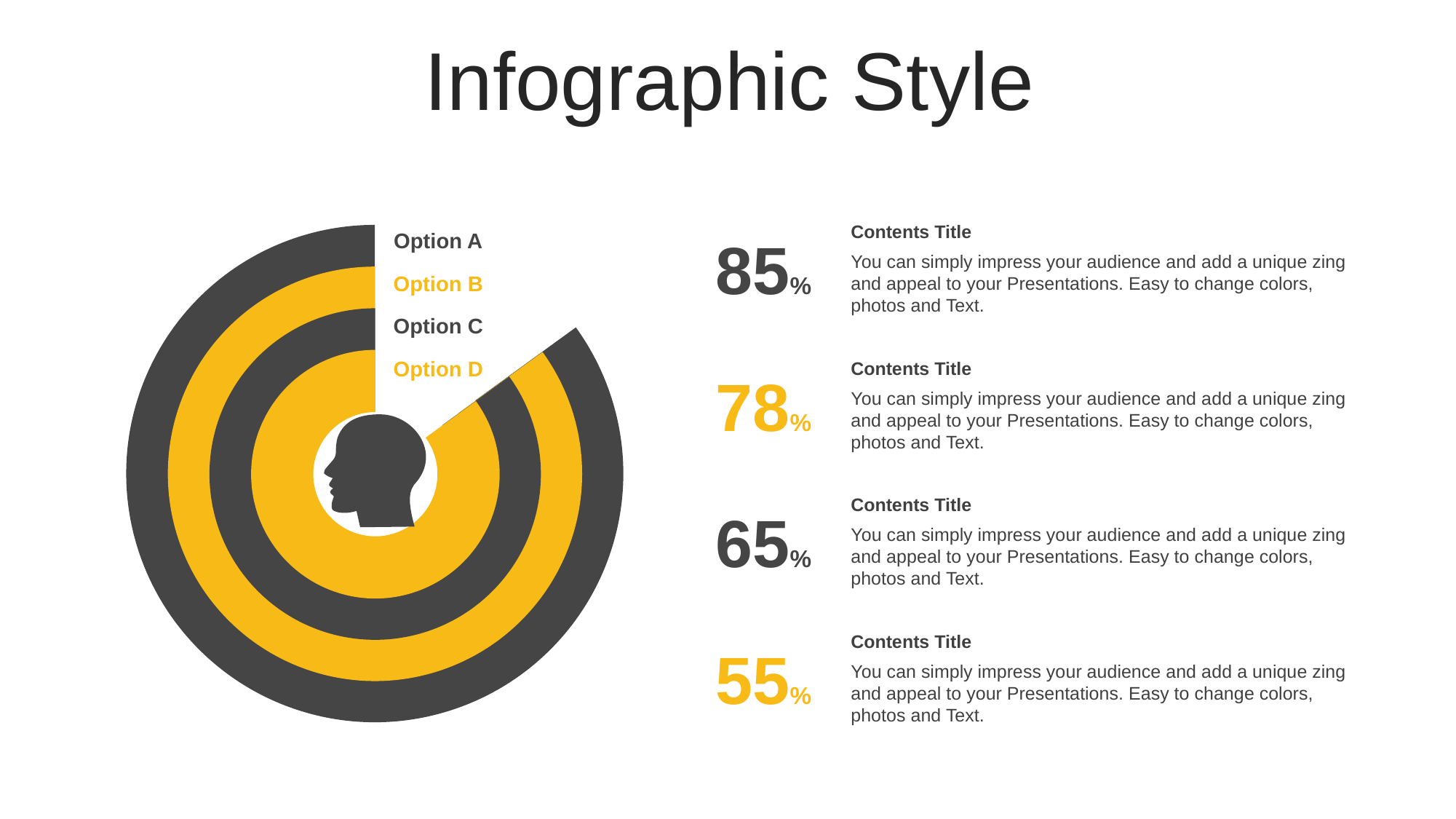
What percentage is listed first, next to the top 'Contents Title' entry? 85% What is the difference between the highest percentage (85%) and the lowest percentage (55%) shown? 30 percentage points What is the highest percentage shown on the slide? 85% Which option labels are shown in yellow? Option B and Option D How many options does the ring chart list? 4 Do the percentages listed on the right increase or decrease from top to bottom? decrease What percentage is listed last, next to the bottom 'Contents Title' entry? 55% Which is larger, the 78% value or the 65% value? 78% Which option label corresponds to the outermost ring of the chart? Option A What is the lowest percentage shown on the slide? 55% What kind of chart is shown on the left of the slide? A concentric ring (doughnut) chart What is the difference between the 78% value and the 65% value? 13 percentage points